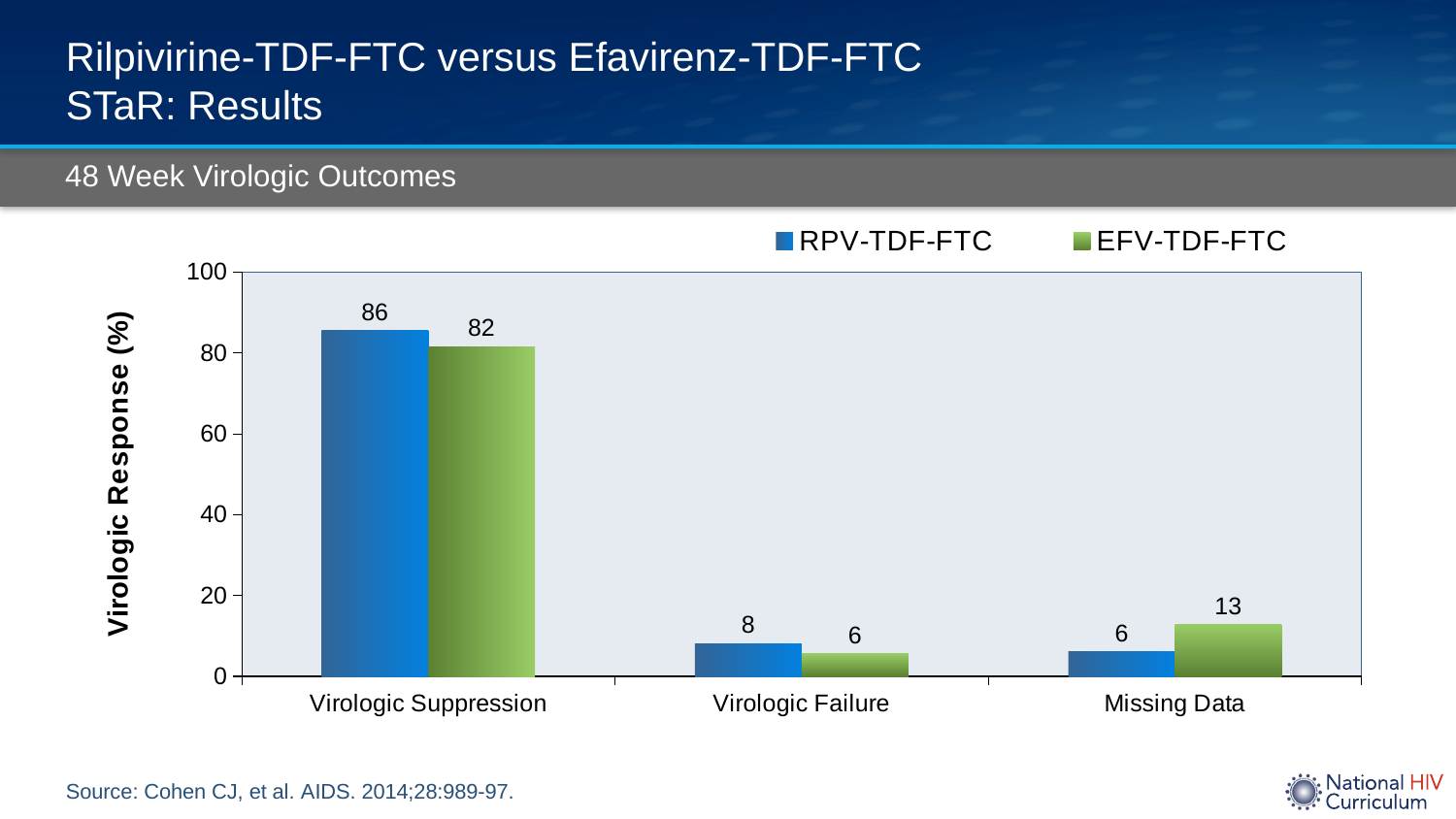
What is the difference between the RPV-TDF-FTC and EFV-TDF-FTC values for Virologic Suppression? 4 What is the value for EFV-TDF-FTC in the Virologic Failure category? 6 How many categories are shown on the x axis? 3 Which category has the lowest value for EFV-TDF-FTC? Virologic Failure What kind of chart is shown on the slide? bar chart What is the difference between the EFV-TDF-FTC and RPV-TDF-FTC values for Missing Data? 7 What is the value for EFV-TDF-FTC in the Missing Data category? 13 Which category has the highest value for RPV-TDF-FTC? Virologic Suppression What is the value for RPV-TDF-FTC in the Virologic Suppression category? 86 Which series has the larger value for Missing Data, RPV-TDF-FTC or EFV-TDF-FTC? EFV-TDF-FTC How many series does the legend list? 2 Is the value for RPV-TDF-FTC in Virologic Suppression greater or less than 80? greater